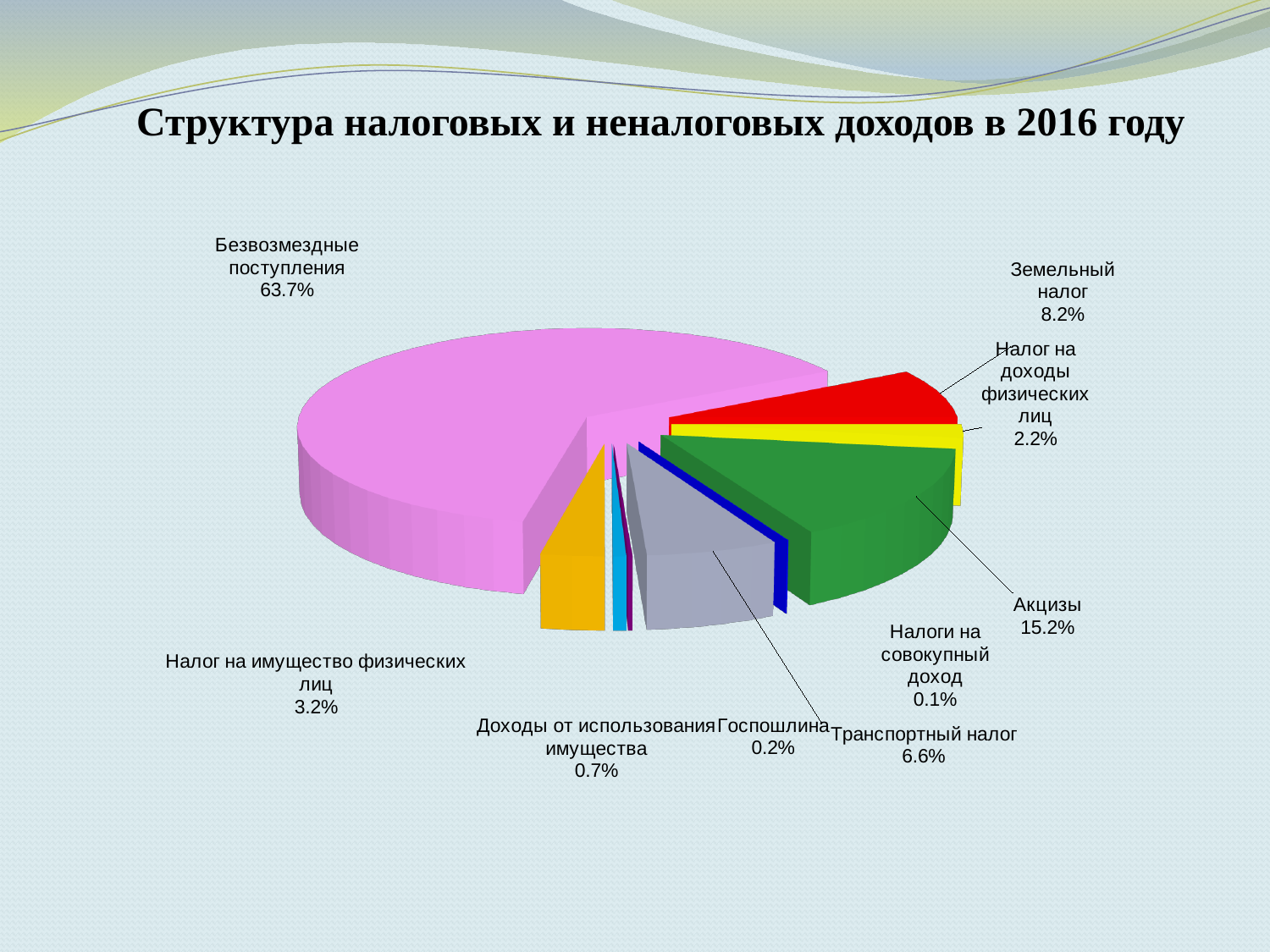
What is the value for Акцизы? 15.2% Which category has the smallest share of the pie? Налоги на совокупный доход What is the value for Транспортный налог? 6.6% What kind of chart is shown on the slide? Pie chart What is the value for Земельный налог? 8.2% What is the difference between the shares of Акцизы and Земельный налог? 7.0% Which is larger, Транспортный налог or Налог на доходы физических лиц? Транспортный налог Which category has the largest share of the pie? Безвозмездные поступления What is the value for Налог на имущество физических лиц? 3.2% What is the title of the chart? Структура налоговых и неналоговых доходов в 2016 году How many categories are shown in the pie chart? 9 What share of the pie is Безвозмездные поступления? 63.7%